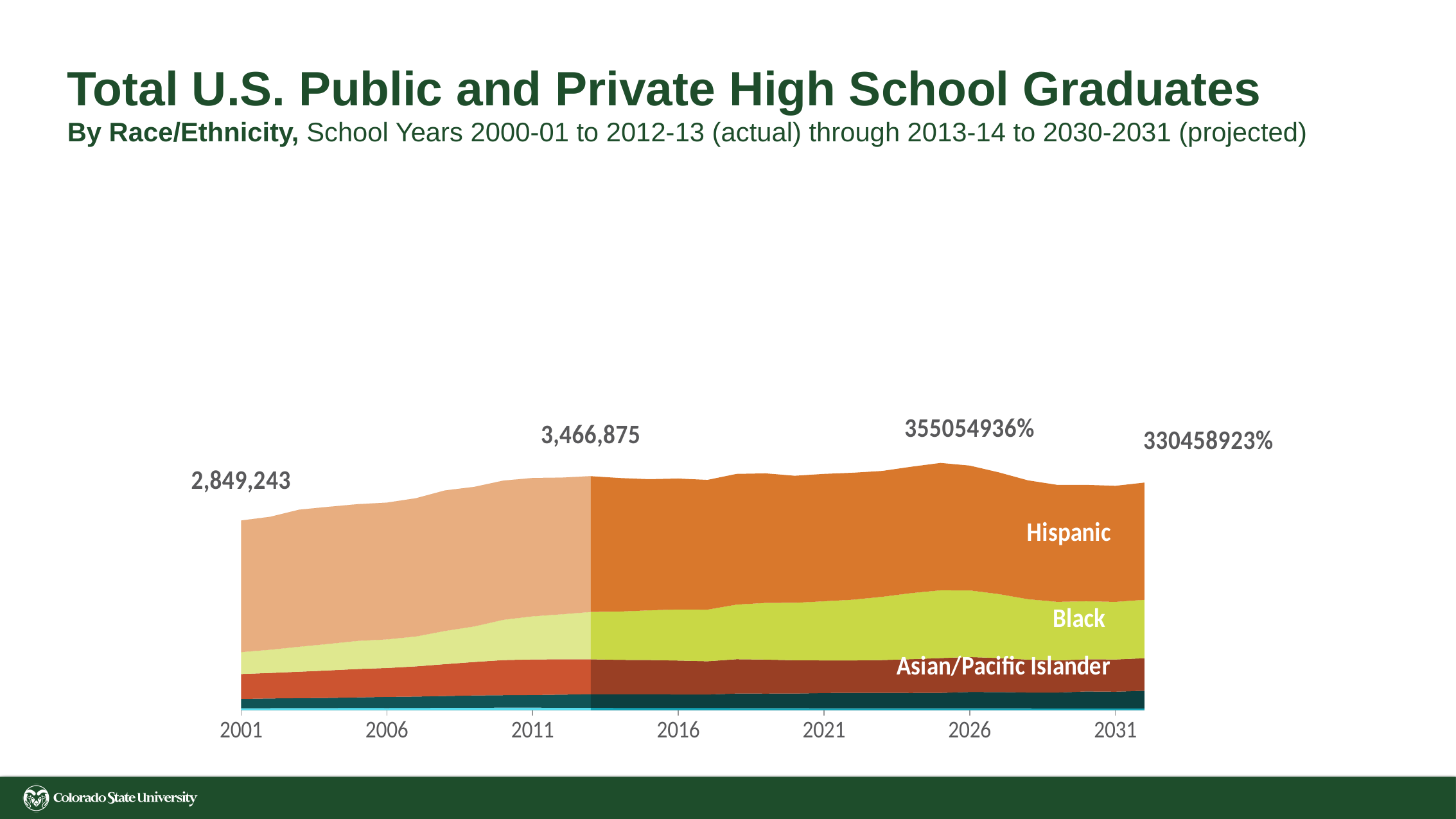
Does the total height of the stacked area rise or fall from 2001 to 2011? rise What kind of chart is shown on the slide? area chart Which labeled area is the largest at the right end of the chart? Hispanic What is the main title of the slide? Total U.S. Public and Private High School Graduates Which is larger, the 2001 data label or the second data label from the left? the second data label (3,466,875) What is the second data label from the left on the chart, shown above the boundary between the actual and projected sections? 3,466,875 What is the data label shown at the far right of the chart, above 2031? 330458923% How many year labels are shown on the x axis? 7 What is the data label shown above the 2026 area of the chart? 355054936% Which race/ethnicity labels are printed inside the chart areas? Hispanic, Black, Asian/Pacific Islander What is the difference between the second data label from the left (3,466,875) and the 2001 label (2,849,243)? 617,632 What is the data label shown at the start of the chart, above 2001? 2,849,243